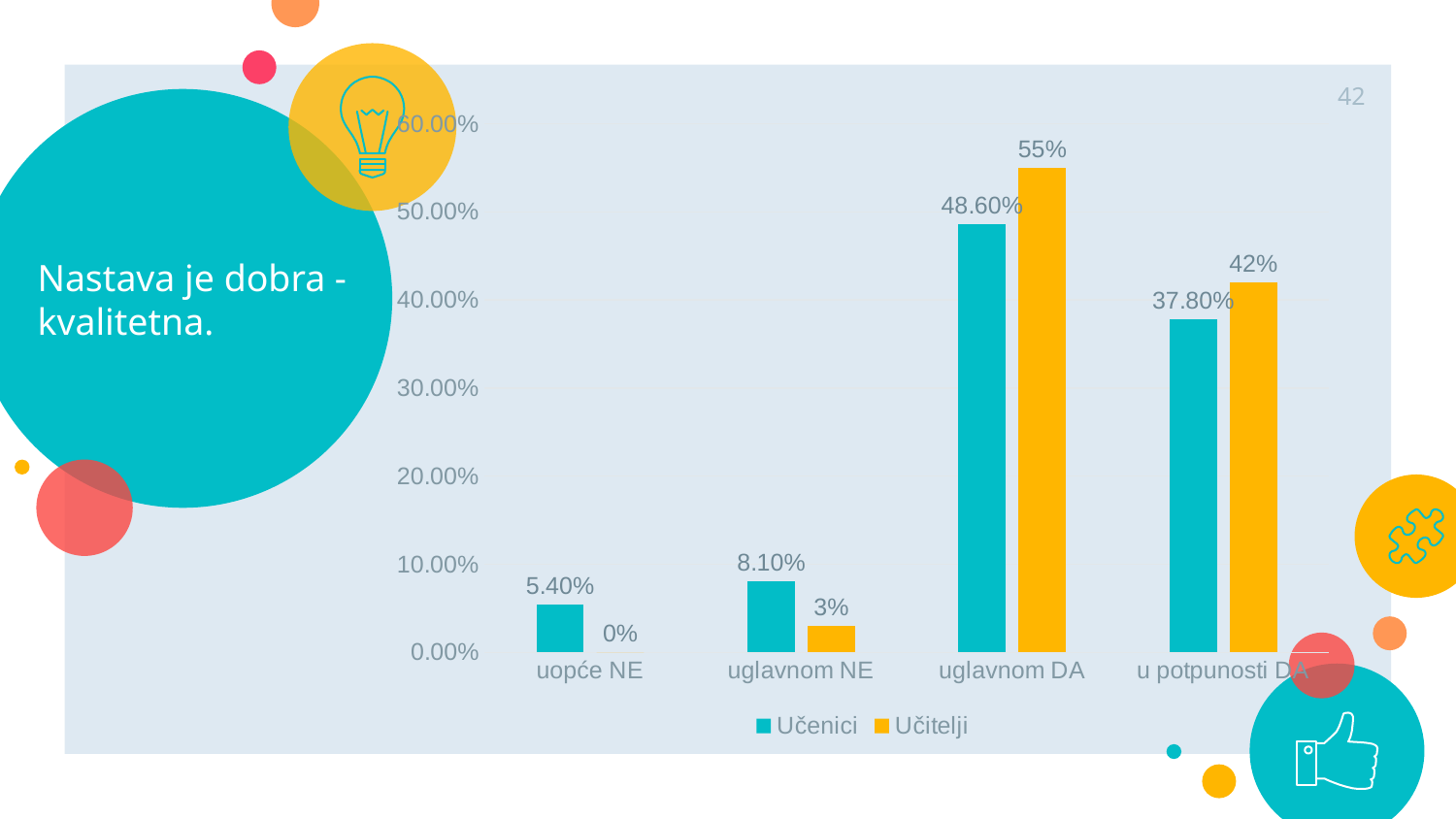
Which category has the highest value for Učitelji? uglavnom DA What is the value for Učenici in the 'uglavnom DA' category? 48.60% What is the difference between the Učitelji and Učenici values in the 'uglavnom DA' category? 6.40% How many series does the legend list? 2 What type of chart is shown on the slide? bar chart Which colour represents the Učitelji series? orange What is the value for Učitelji in the 'u potpunosti DA' category? 42% In the 'uglavnom NE' category, which series has the larger value, Učenici or Učitelji? Učenici Is the Učenici value for 'u potpunosti DA' greater or less than 40.00%? less How many categories are shown on the x axis? 4 What is the value for Učitelji in the 'uopće NE' category? 0% Which category has the lowest value for Učenici? uopće NE